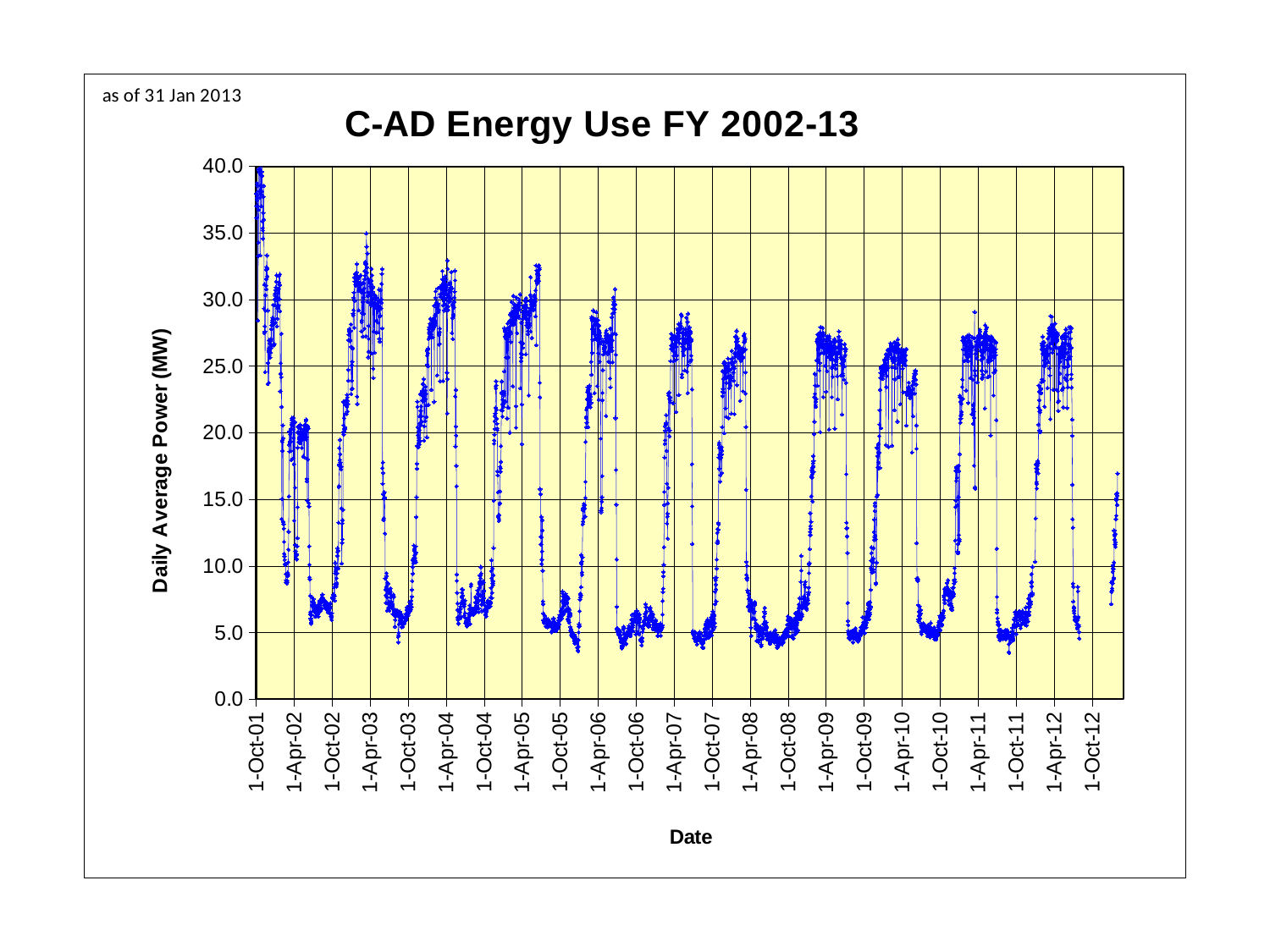
What is the highest value shown on the vertical axis? 40.0 Are the plotted values at the very start of the series, near 1-Oct-01, greater or less than 35.0? greater What kind of chart is shown on the slide? line chart How many date labels are shown along the x axis? 23 Around which x-axis date do the highest plotted values appear? 1-Oct-01 Are the plotted values near 1-Oct-08 greater or less than 10.0? less Do the yearly peak values generally rise or fall from 2001 to 2012? fall Are the plotted values near 1-Oct-12 greater or less than 20.0? less What is the title of the chart? C-AD Energy Use FY 2002-13 Which has larger plotted values: the points near 1-Oct-01 or the points near 1-Apr-12? 1-Oct-01 What is the label of the vertical axis? Daily Average Power (MW)